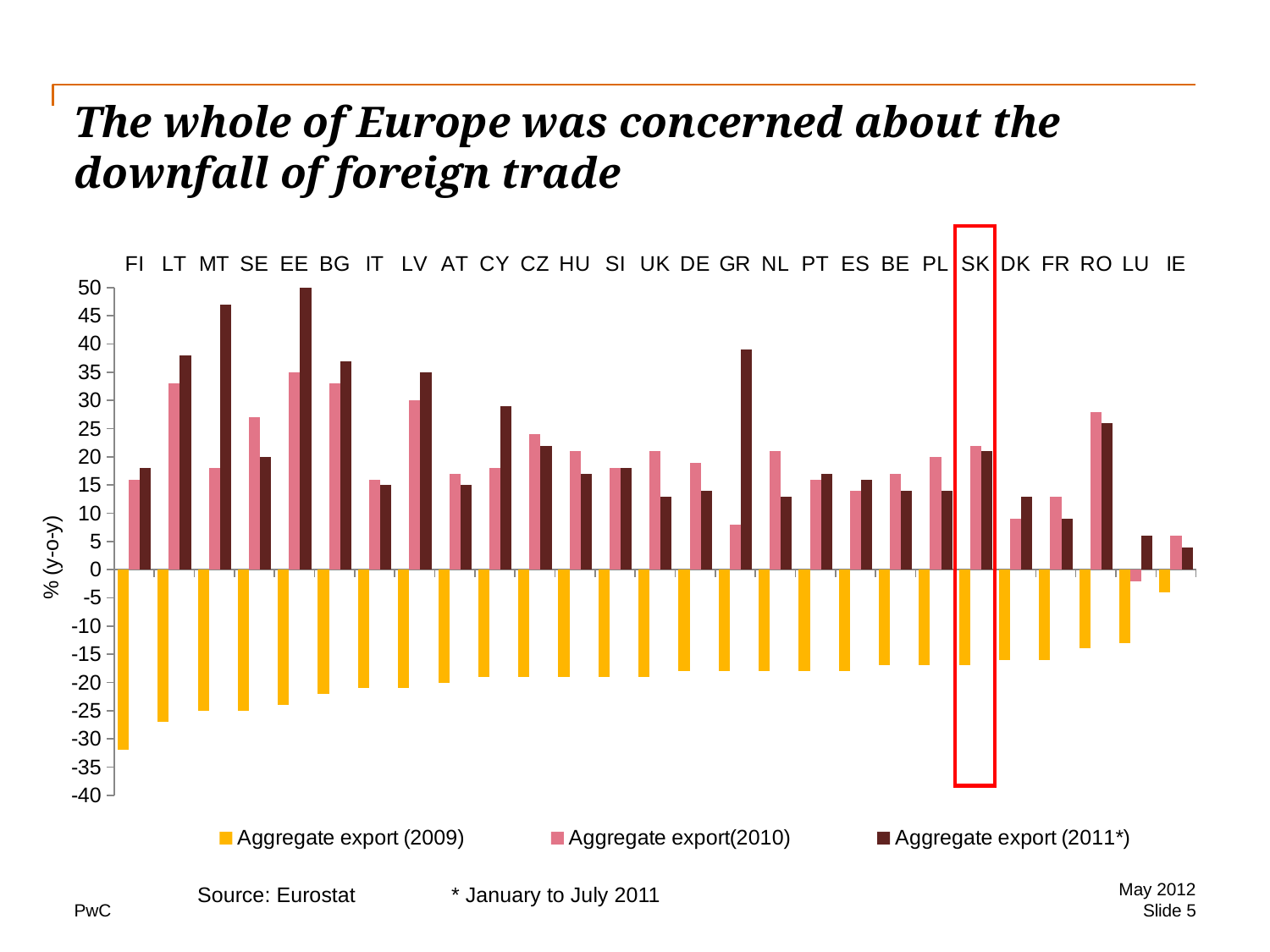
How many series does the legend list? 3 Which country has the lowest Aggregate export (2009) value? FI Is the Aggregate export (2011*) value for LU greater or less than 10? less What kind of chart is shown on the slide? bar chart Which country has the highest Aggregate export (2011*) value? EE Which country is highlighted with a red box on the chart? SK For UK, which is larger: Aggregate export (2010) or Aggregate export (2011*)? Aggregate export (2010) For GR, which is larger: Aggregate export (2010) or Aggregate export (2011*)? Aggregate export (2011*) How many countries are shown on the x axis? 27 Is the Aggregate export (2011*) value for GR greater or less than 35? greater Is the Aggregate export (2011*) value for MT greater or less than 45? greater